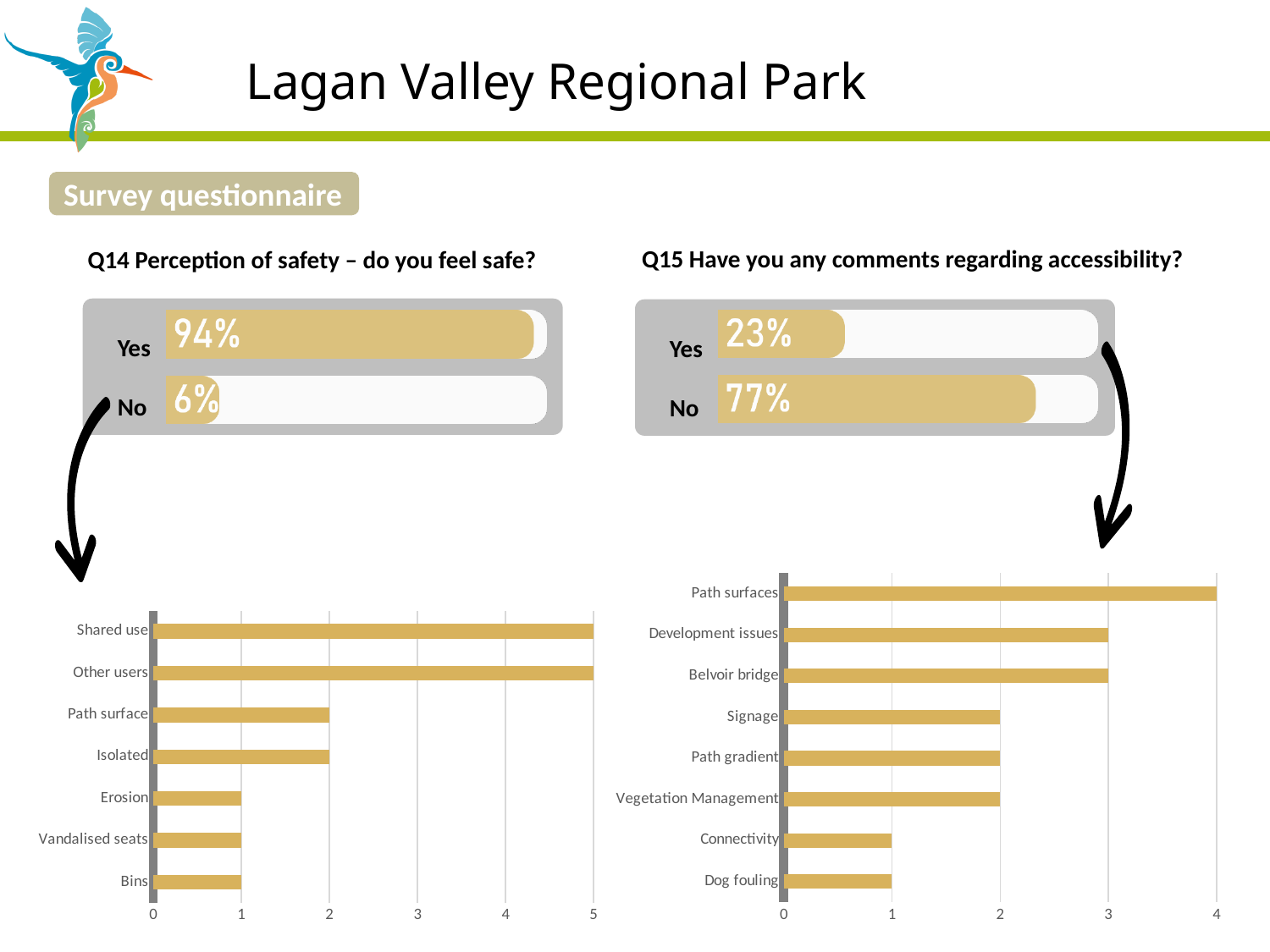
On the right bar chart (under Q15), how many categories are shown? 8 On the left bar chart (under Q14), which is larger, Isolated or Bins? Isolated On the left bar chart (under Q14), what is the value for Path surface? 2 On the right bar chart (under Q15), what is the difference between the values for Path surfaces and Signage? 2 On the right bar chart (under Q15), which category has the highest value? Path surfaces On the right bar chart (under Q15), what is the value for Development issues? 3 What kind of chart is the chart on the right (under Q15)? Bar chart On the left bar chart (under Q14), what is the value for Shared use? 5 On the right bar chart (under Q15), what is the value for Connectivity? 1 In the Q14 Perception of safety graphic, what percentage answered Yes? 94% On the left bar chart (under Q14), what is the difference between the values for Shared use and Erosion? 4 On the left bar chart (under Q14), how many categories are shown? 7